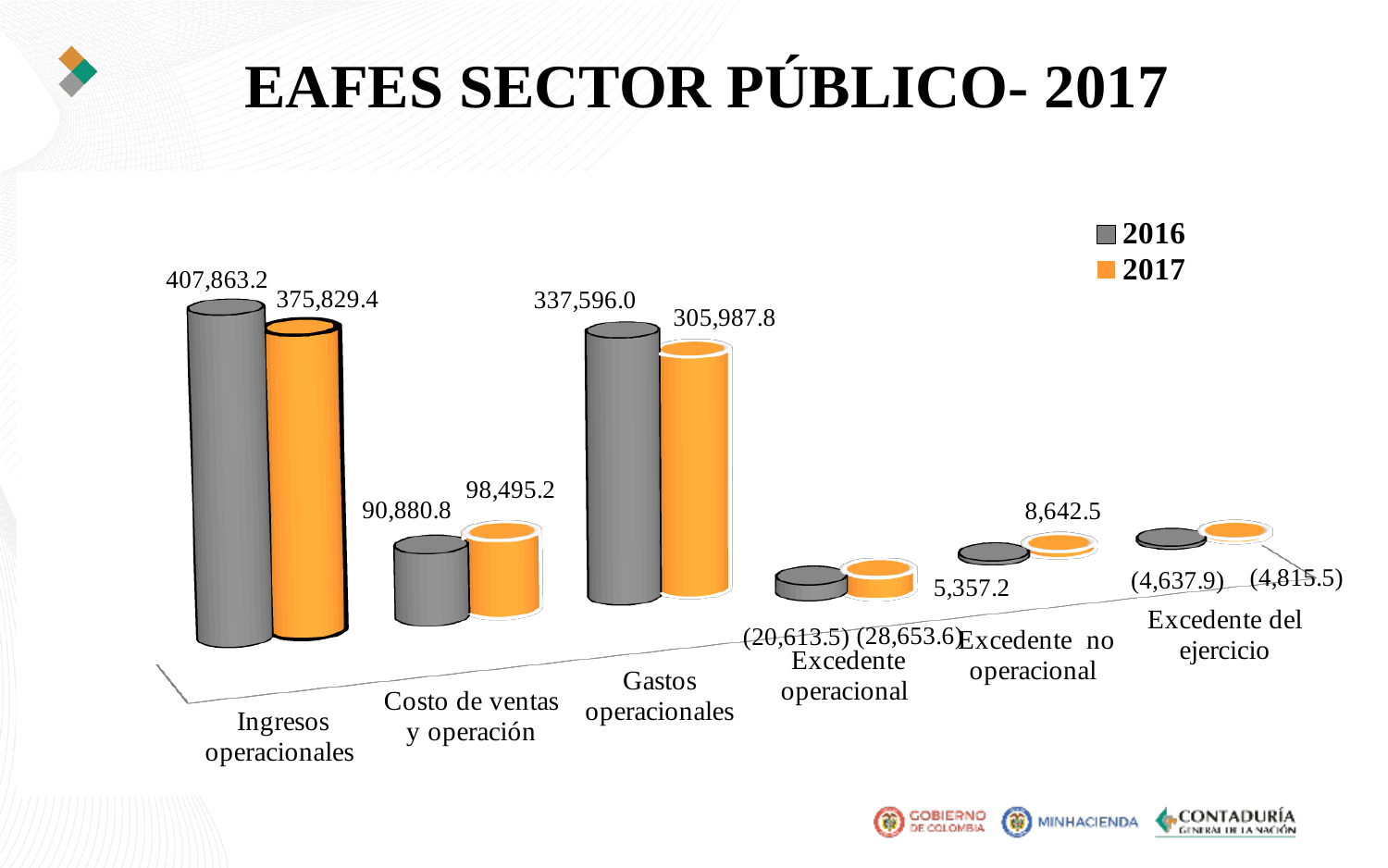
What is the difference between the 2016 and 2017 values for Ingresos operacionales? 32,033.8 What is the 2017 value for Costo de ventas y operación? 98,495.2 How many series does the legend list? 2 What is the 2016 value for Excedente operacional? (20,613.5) For Costo de ventas y operación, which year has the larger value, 2016 or 2017? 2017 What is the difference between the 2017 and 2016 values for Excedente no operacional? 3,285.3 What is the 2016 value for Ingresos operacionales? 407,863.2 What type of chart is shown on the slide? Bar chart How many categories are shown on the x axis? 6 What is the 2017 value for Excedente del ejercicio? (4,815.5) What is the 2017 value for Gastos operacionales? 305,987.8 Which category has the highest 2017 value? Ingresos operacionales